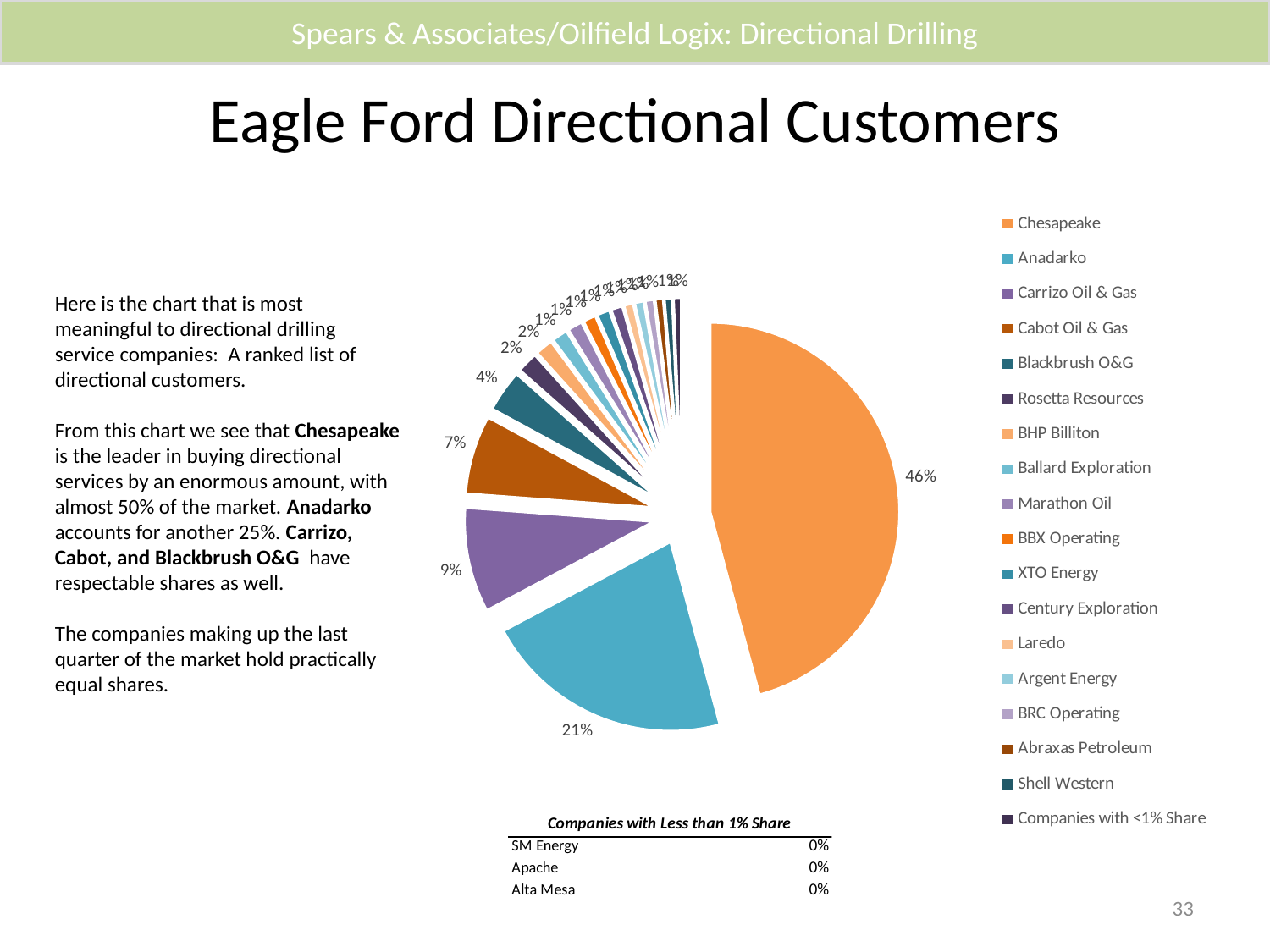
What is the combined share of Chesapeake and Anadarko? 67% What is the value shown for Carrizo Oil & Gas? 9% How many entries does the legend of the pie chart list? 18 What is the value shown for Blackbrush O&G? 4% What is the value shown for Cabot Oil & Gas? 7% What kind of chart is shown on the slide? pie chart What is the difference in percentage points between Chesapeake's share and Anadarko's share? 25 percentage points What colour is used for Chesapeake in the pie chart? orange What share of the pie does Chesapeake hold? 46% Which company has the largest slice of the pie? Chesapeake What is the value shown for Anadarko? 21% Which is larger, the slice for Anadarko or the slice for Carrizo Oil & Gas? Anadarko